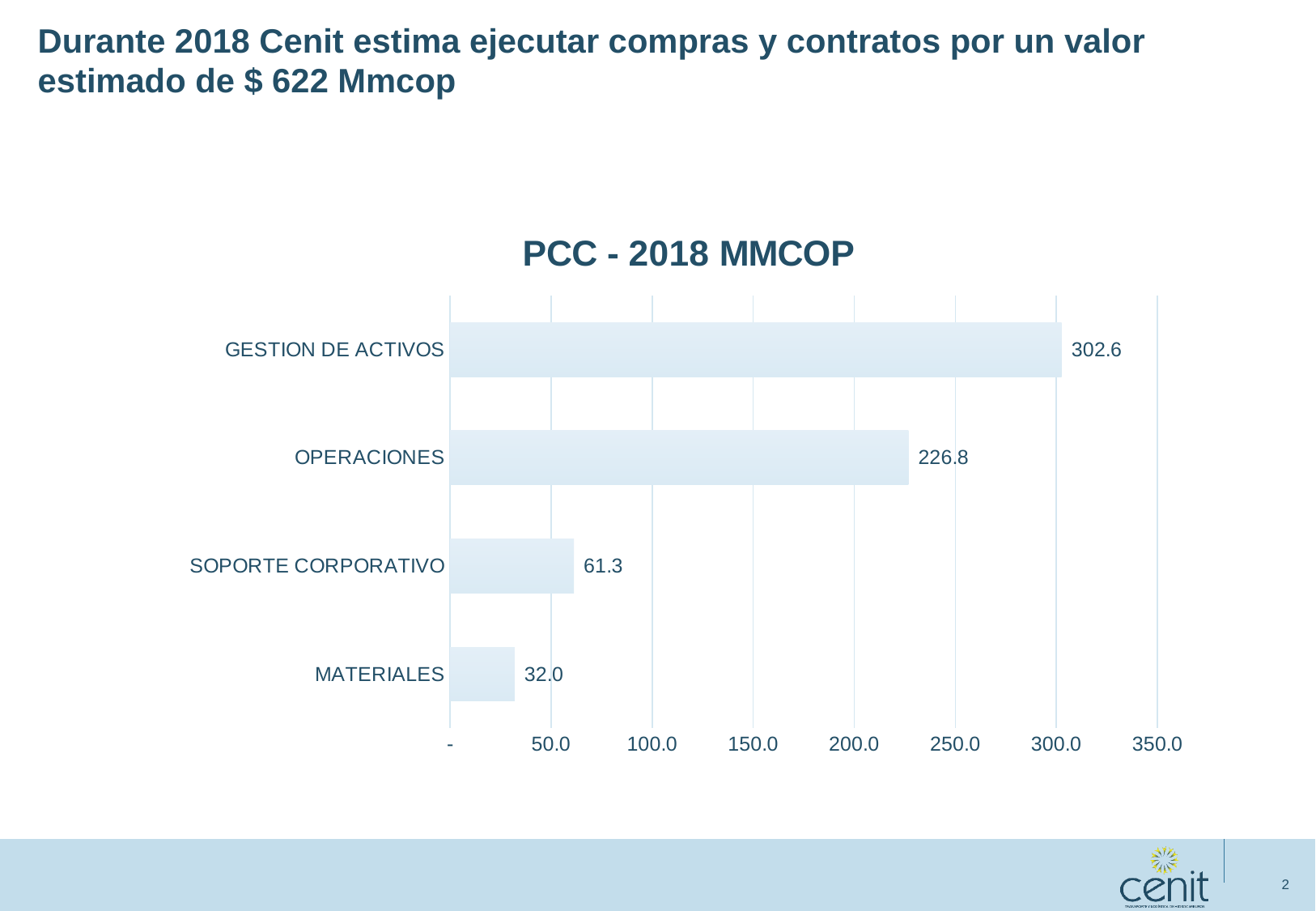
What is the value for MATERIALES? 32.0 Which is larger, the value for OPERACIONES or the value for SOPORTE CORPORATIVO? OPERACIONES What is the value for OPERACIONES? 226.8 Is the value for OPERACIONES greater or less than 200.0? greater Which category has the highest value? GESTION DE ACTIVOS What is the difference between the values for SOPORTE CORPORATIVO and MATERIALES? 29.3 What is the value for GESTION DE ACTIVOS? 302.6 What is the difference between the values for GESTION DE ACTIVOS and OPERACIONES? 75.8 How many categories are shown in the chart? 4 Which category has the lowest value? MATERIALES What is the value for SOPORTE CORPORATIVO? 61.3 What is the title of the chart? PCC - 2018 MMCOP